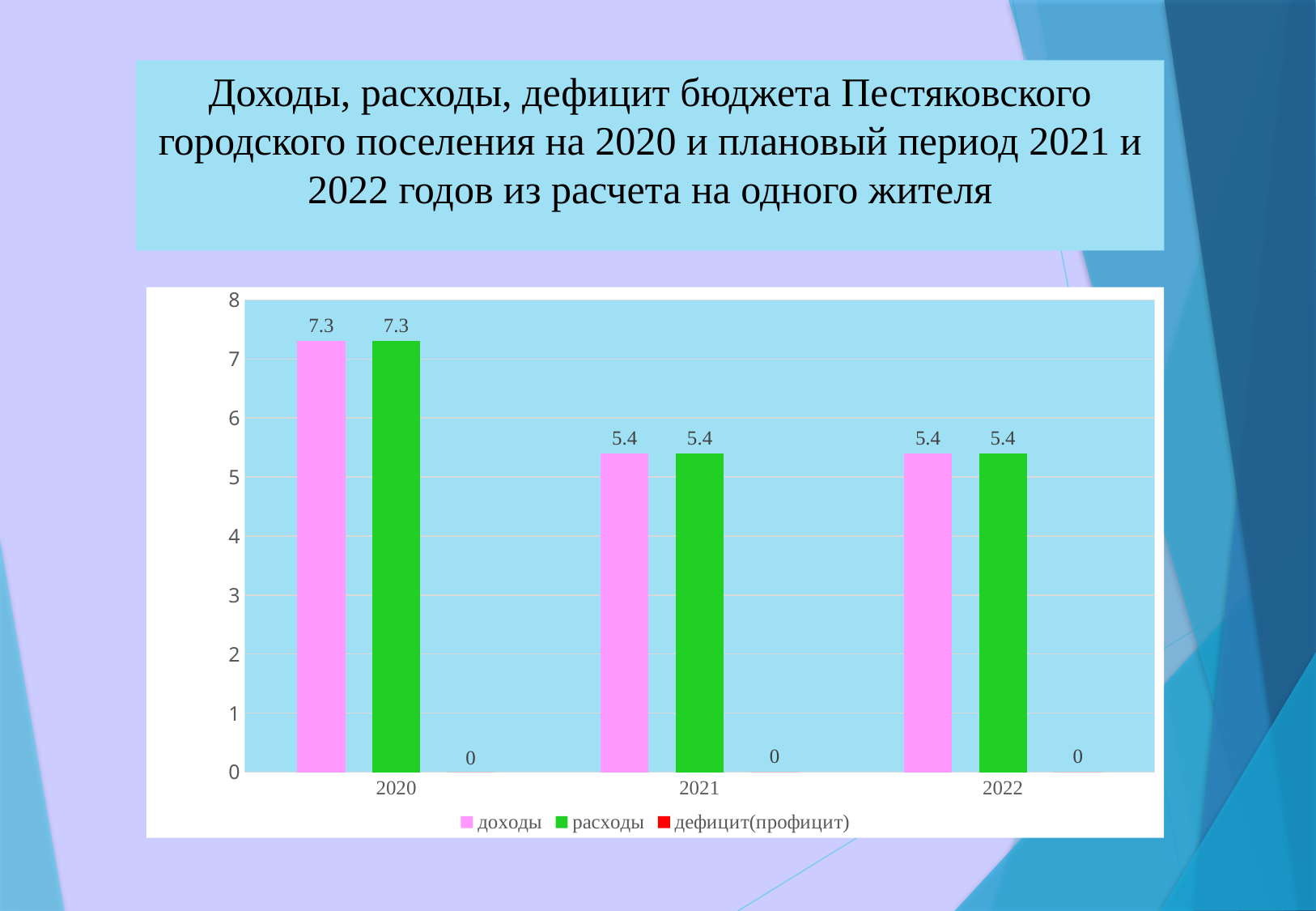
What is the difference between доходы in 2020 and доходы in 2021? 1.9 What colour are the расходы bars? green Do the доходы values rise or fall from 2020 to 2021? fall How many years are shown on the x axis? 3 How many series does the legend list? 3 Is the value of расходы for 2020 greater or less than 7? greater What is the value of дефицит(профицит) for 2022? 0 What kind of chart is shown on the slide? bar chart Which is larger, расходы in 2020 or расходы in 2022? расходы in 2020 In which year is доходы highest? 2020 What is the value of доходы for 2020? 7.3 What is the value of расходы for 2021? 5.4